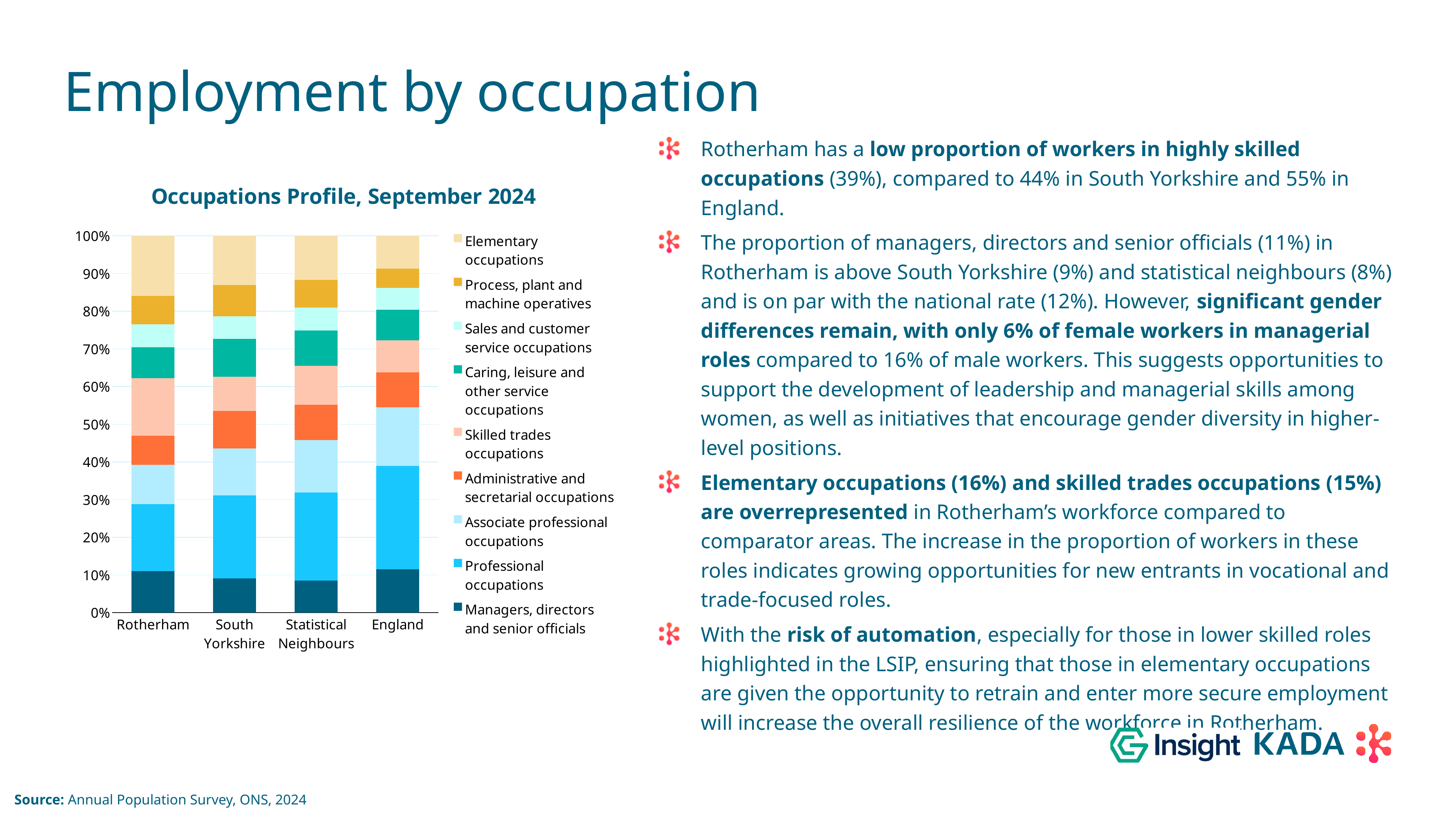
What kind of chart is shown on the slide? Stacked bar chart How many areas (categories) are shown on the x axis of the chart? 4 Which area has the largest Professional occupations segment? England Is the Skilled trades occupations share for Rotherham greater or less than 10%? greater Is the Professional occupations segment larger for England or for Rotherham? England What is the total height of each stacked bar in the chart? 100% Which area has the largest Elementary occupations segment? Rotherham What is the title of the chart? Occupations Profile, September 2024 Is the Professional occupations share for England greater or less than 20%? greater How many occupation groups does the chart legend list? 9 Which area has the smallest Elementary occupations segment? England Is the Managers, directors and senior officials segment larger for Rotherham or for Statistical Neighbours? Rotherham